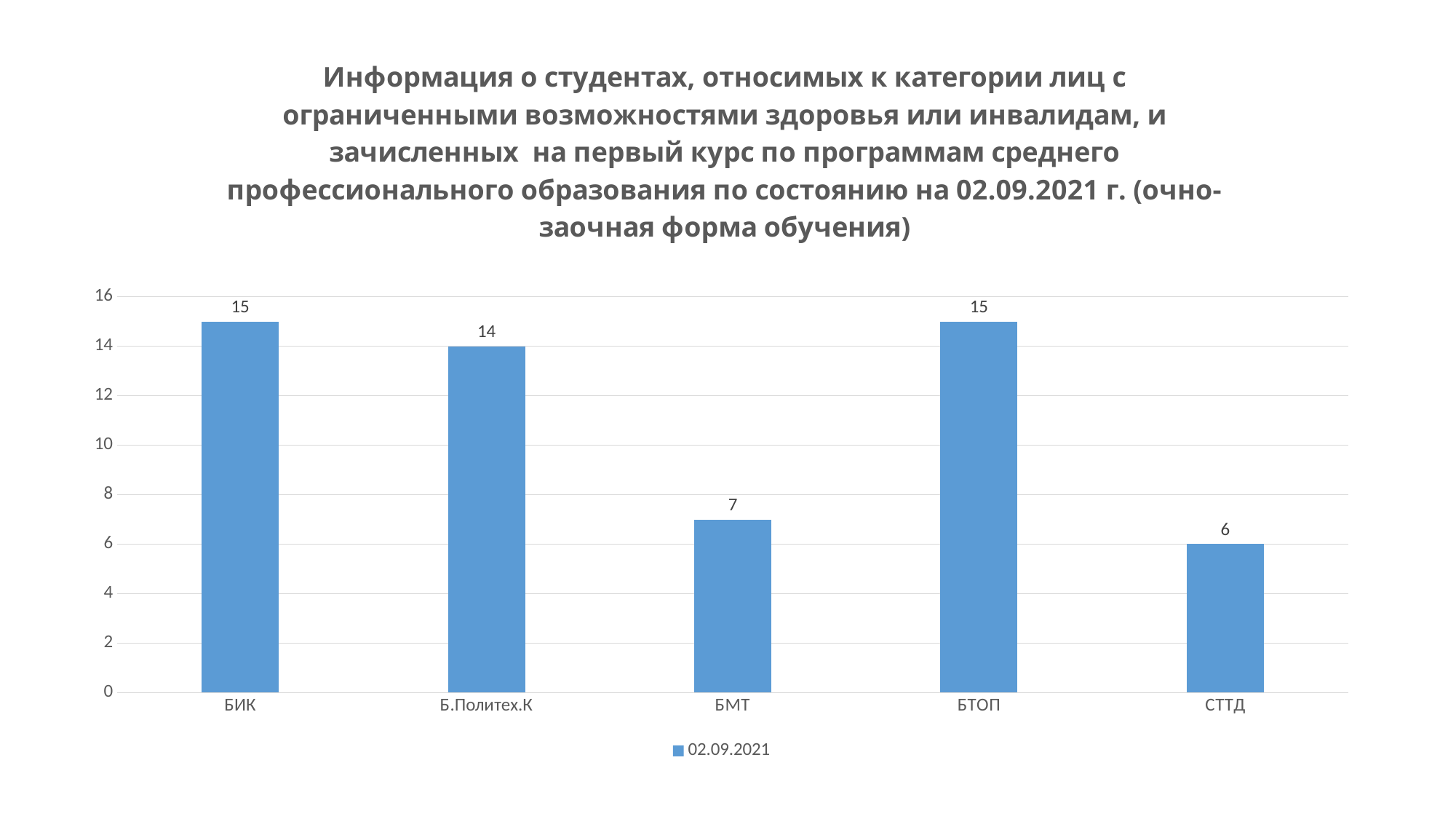
Which is larger, the value for Б.Политех.К or the value for СТТД? Б.Политех.К How many categories are shown on the x axis? 5 What kind of chart is shown on the slide? bar chart What is the difference between the values for БТОП and БМТ? 8 What is the value for БИК? 15 What is the legend entry for the series? 02.09.2021 What is the value for Б.Политех.К? 14 What is the value for СТТД? 6 What is the value for БМТ? 7 Which category has the lowest value? СТТД Is the value for БМТ greater or less than 8? less How many series does the legend list? 1